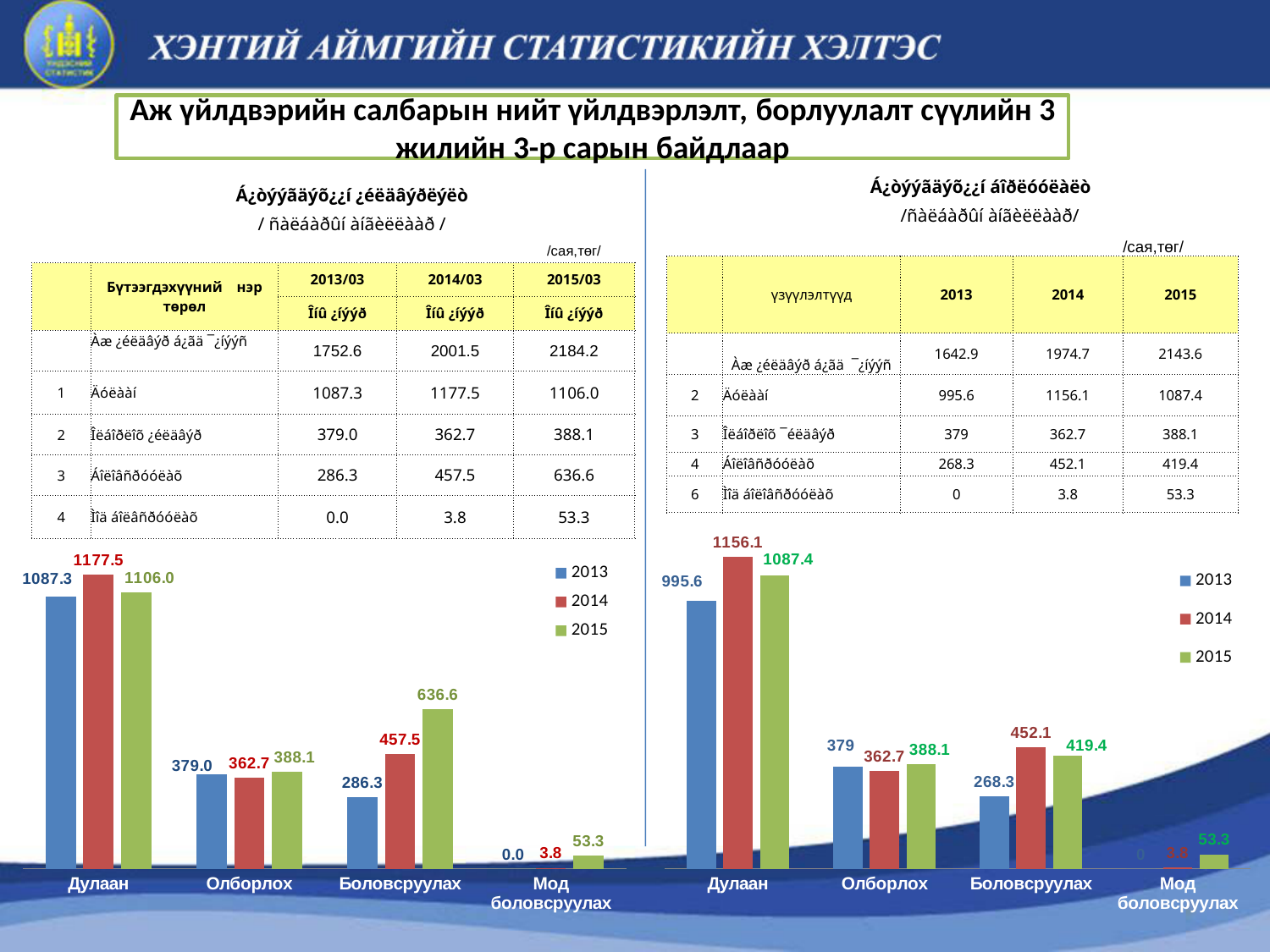
In the right chart, which category has the highest 2014 value? Дулаан How many categories are shown on the x axis of the right chart? 4 In the right chart, which is larger for Дулаан: the 2014 value or the 2015 value? 2014 In the left chart, which category has the lowest 2013 value? Мод боловсруулах In the right chart, what is the 2013 value for Дулаан? 995.6 In the left chart, what is the 2015 value for Боловсруулах? 636.6 In the right chart, what is the difference between the 2014 and 2015 values for Боловсруулах? 32.7 In the right chart, what is the 2014 value for Боловсруулах? 452.1 In the left chart, what is the difference between the 2015 and 2013 values for Боловсруулах? 350.3 In the left chart, what is the 2014 value for Дулаан? 1177.5 How many series does the legend of the left chart list? 3 What type of chart is the left chart? Bar chart